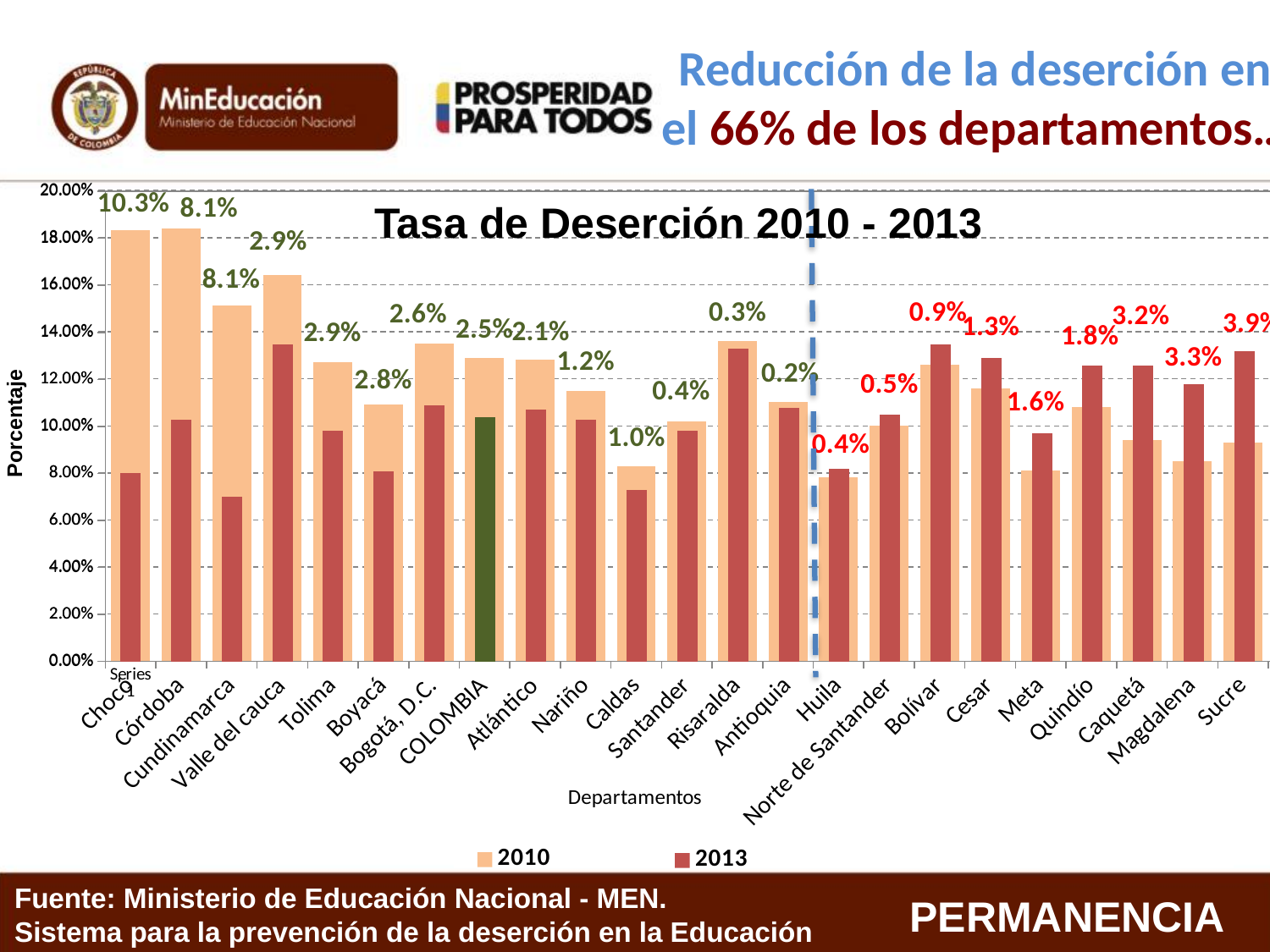
Is the 2010 value for Chocó greater or less than 16.00%? greater Is the 2010 value for Caldas greater or less than 10.00%? less How many series does the chart legend list? 2 What kind of chart is shown on the slide? bar chart How many departments (categories) are shown along the x axis of the chart? 23 Which is larger for Sucre, the 2010 value or the 2013 value? 2013 Is the 2013 value for Chocó greater or less than 10.00%? less Which category's 2013 bar is coloured green instead of red? COLOMBIA Which is larger for Chocó, the 2010 value or the 2013 value? 2010 What is the title of the chart? Tasa de Deserción 2010 - 2013